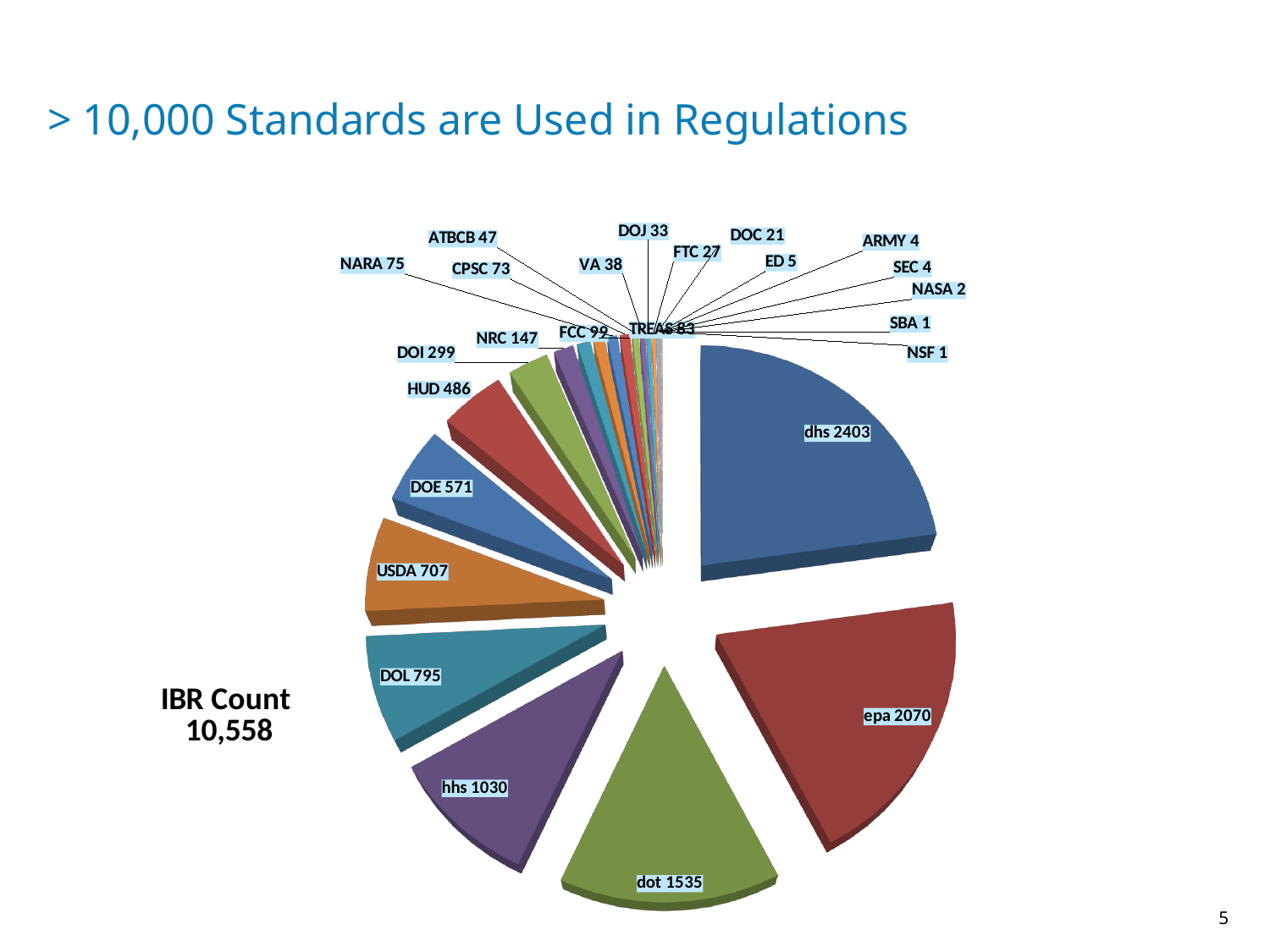
What is the difference between the values for dhs and epa? 333 What type of chart is shown on the slide? pie chart What is the value for USDA? 707 What IBR Count total is stated next to the chart? 10,558 Which is larger, the value for DOE or the value for USDA? USDA What is the value for dhs? 2403 What is the value for HUD? 486 Which category has the largest slice of the pie? dhs What is the difference between the values for hhs and DOL? 235 What is the value for dot? 1535 What is the value for epa? 2070 Which is larger, the value for NRC or the value for DOI? DOI